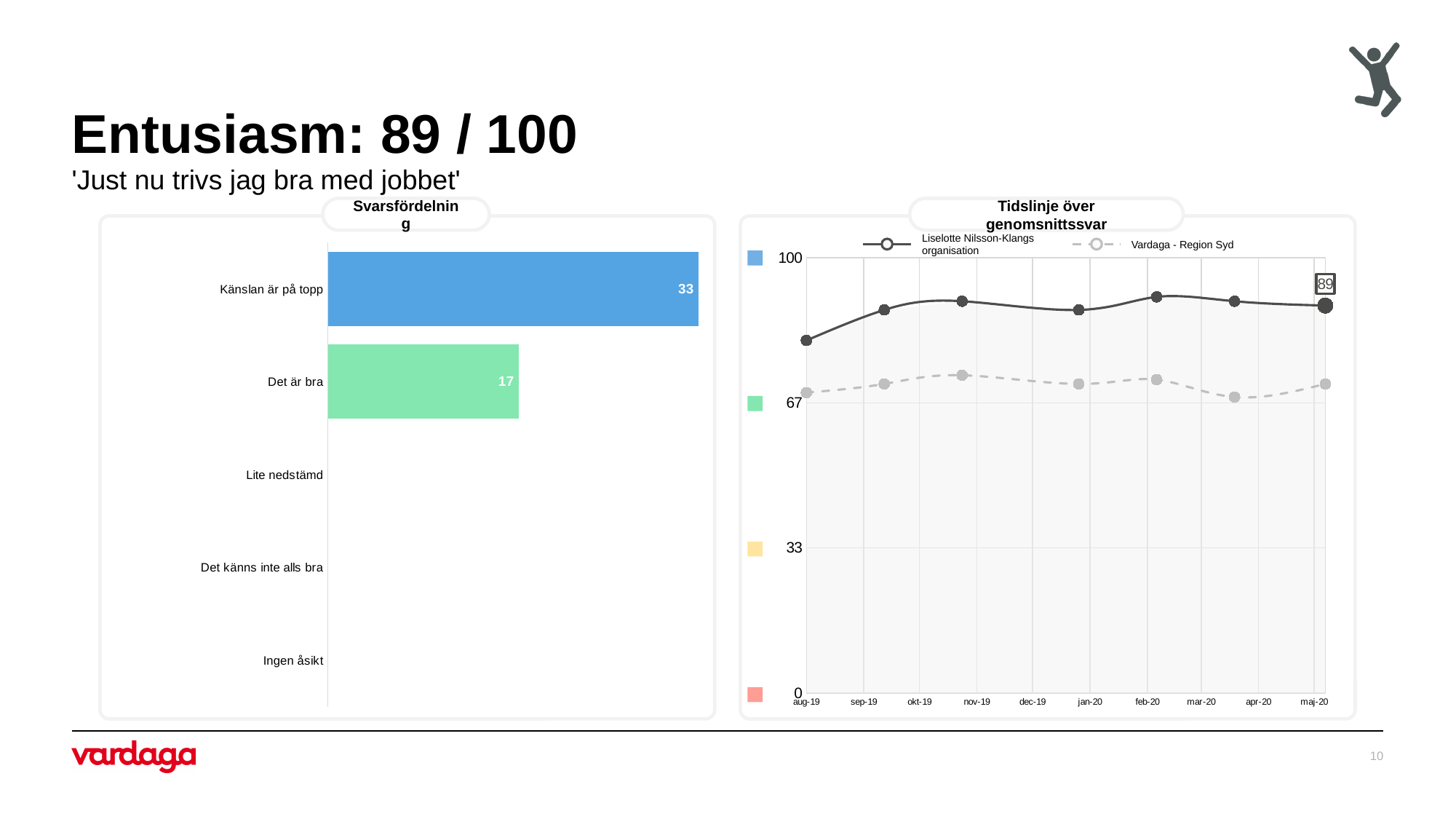
In the 'Svarsfördelning' chart, what is the value for 'Det är bra'? 17 What kind of chart is the 'Tidslinje över genomsnittssvar' chart on the right? line chart In the 'Svarsfördelning' chart, what is the difference between 'Känslan är på topp' and 'Det är bra'? 16 How many categories are listed in the 'Svarsfördelning' chart? 5 What kind of chart is the 'Svarsfördelning' chart on the left? bar chart How many series does the legend of the 'Tidslinje över genomsnittssvar' chart list? 2 What is the title of the chart on the right side of the slide? Tidslinje över genomsnittssvar In the 'Tidslinje över genomsnittssvar' chart, which series is higher at maj-20: 'Liselotte Nilsson-Klangs organisation' or 'Vardaga - Region Syd'? Liselotte Nilsson-Klangs organisation In the 'Tidslinje över genomsnittssvar' chart, is the value for 'Liselotte Nilsson-Klangs organisation' at aug-19 greater or less than 67? greater In the 'Svarsfördelning' chart, what is the value for 'Känslan är på topp'? 33 In the 'Svarsfördelning' chart, which category has the highest value? Känslan är på topp In the 'Tidslinje över genomsnittssvar' chart, what is the labelled value for 'Liselotte Nilsson-Klangs organisation' at maj-20? 89